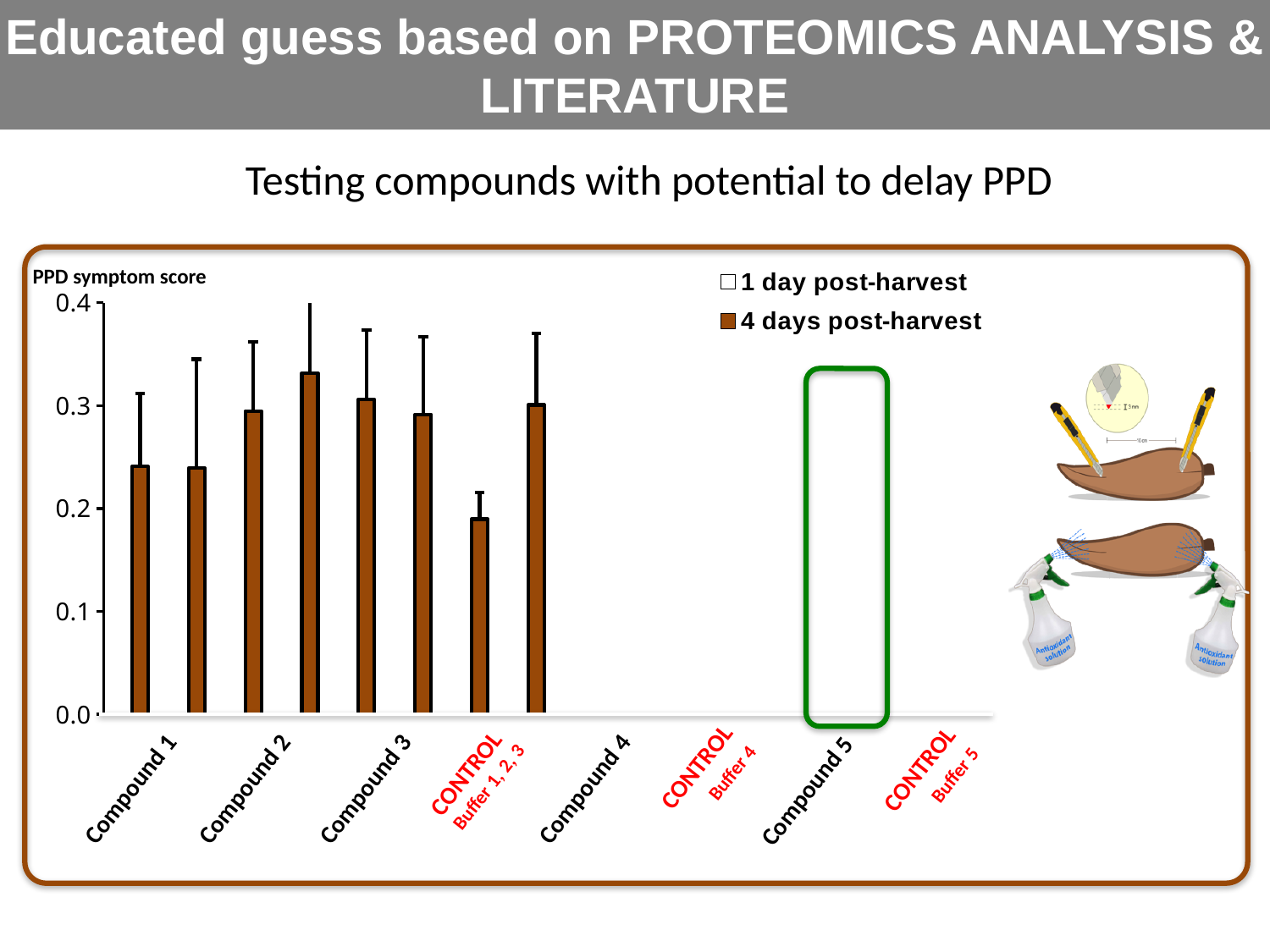
Are the bars for Compound 1 greater or less than 0.3? less How many categories are labelled on the x axis of the chart? 8 What are the two entries in the chart legend? 1 day post-harvest; 4 days post-harvest What kind of chart is shown on the slide? bar chart Are the bars for Compound 3 greater or less than 0.2? greater How many series does the chart legend list? 2 Which is larger: the taller bar for Compound 2 or the taller bar for Compound 1? Compound 2 Is the shorter bar for CONTROL Buffer 1, 2, 3 greater or less than 0.1? greater What is the label on the y axis of the chart? PPD symptom score Which category contains the lowest bar on the chart? CONTROL Buffer 1, 2, 3 How many categories on the chart actually have bars plotted? 4